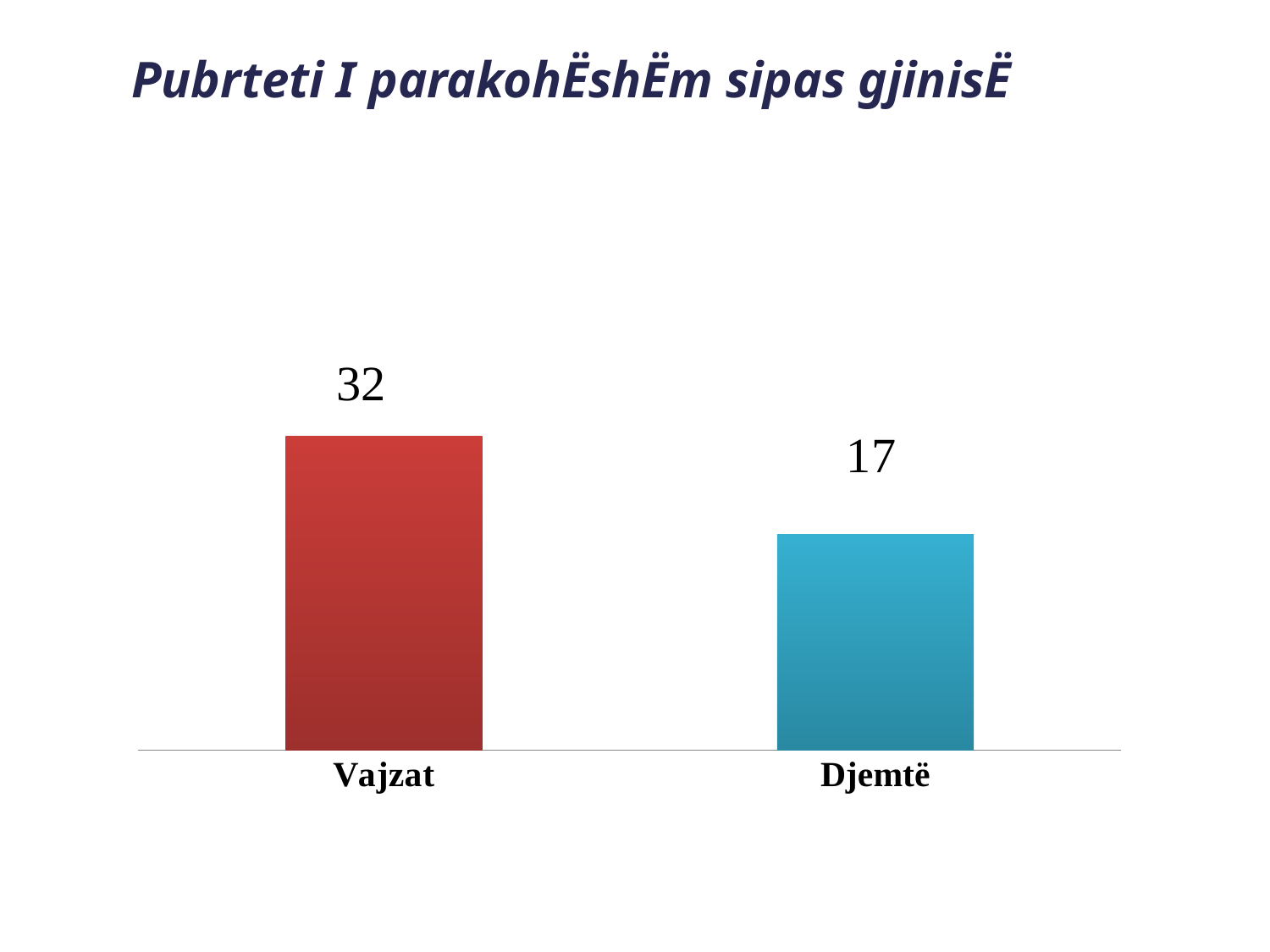
Which is larger, the value for Vajzat or the value for Djemtë? Vajzat What is the title of the slide? Pubrteti I parakohËshËm sipas gjinisË What is the value for Djemtë? 17 How many categories are shown in the chart? 2 What kind of chart is shown on the slide? Bar chart What is the difference between the values for Vajzat and Djemtë? 15 What is the total of the two values shown in the chart? 49 Which category has the lowest value? Djemtë Which category has the highest value? Vajzat What colour is the bar for Djemtë? Blue What is the value for Vajzat? 32